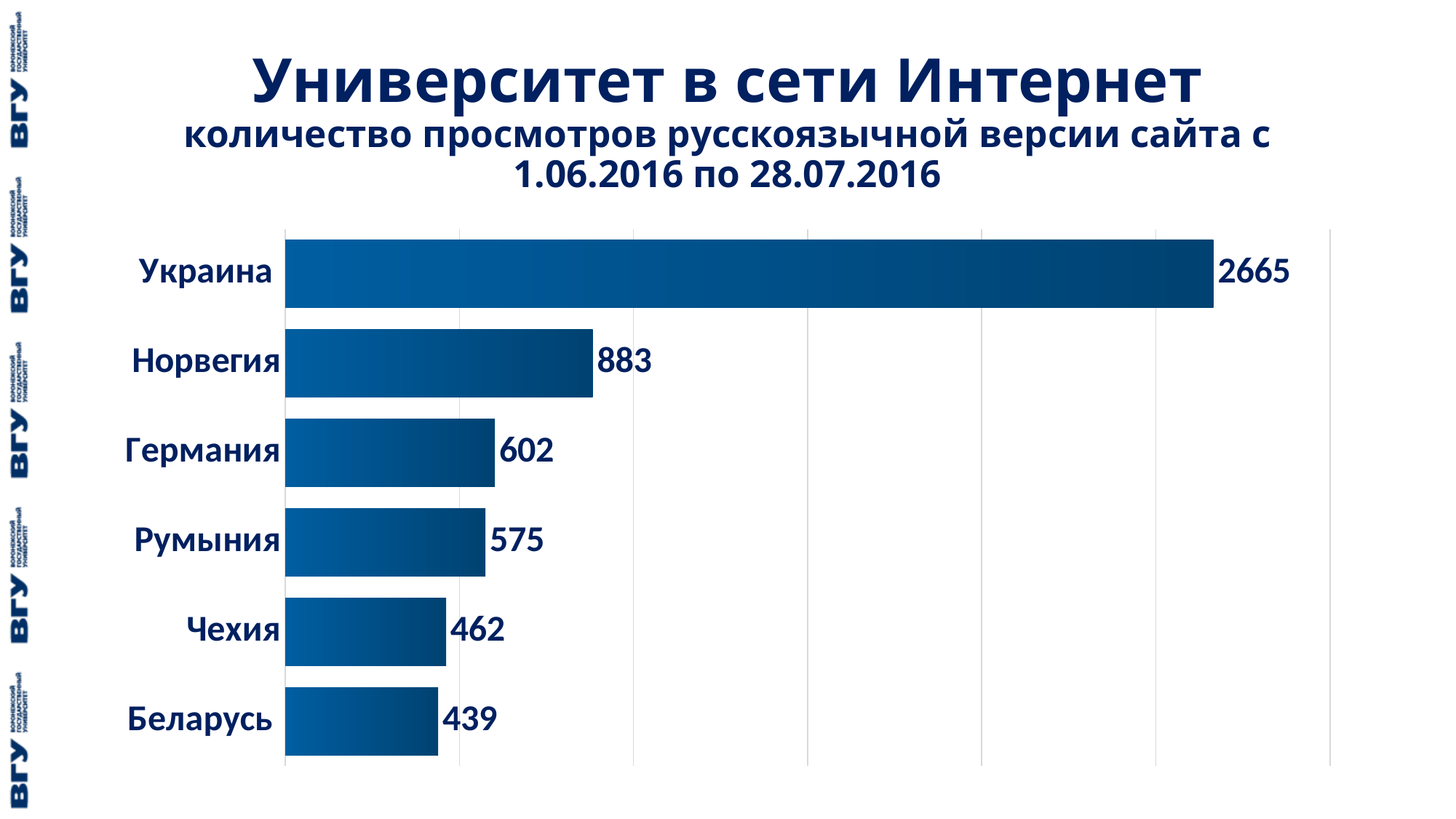
What is the value shown for Германия? 602 What is the main title of the slide? Университет в сети Интернет What is the value shown for Беларусь? 439 Which country has the lowest number of views? Беларусь What is the difference between the values for Чехия and Беларусь? 23 How many countries are shown in the chart? 6 Which has a larger value, Германия or Румыния? Германия What is the difference between the values for Украина and Норвегия? 1782 What is the value shown for Норвегия? 883 Which country has the highest number of views? Украина How many views does the chart show for Украина? 2665 What type of chart is shown on the slide? Bar chart